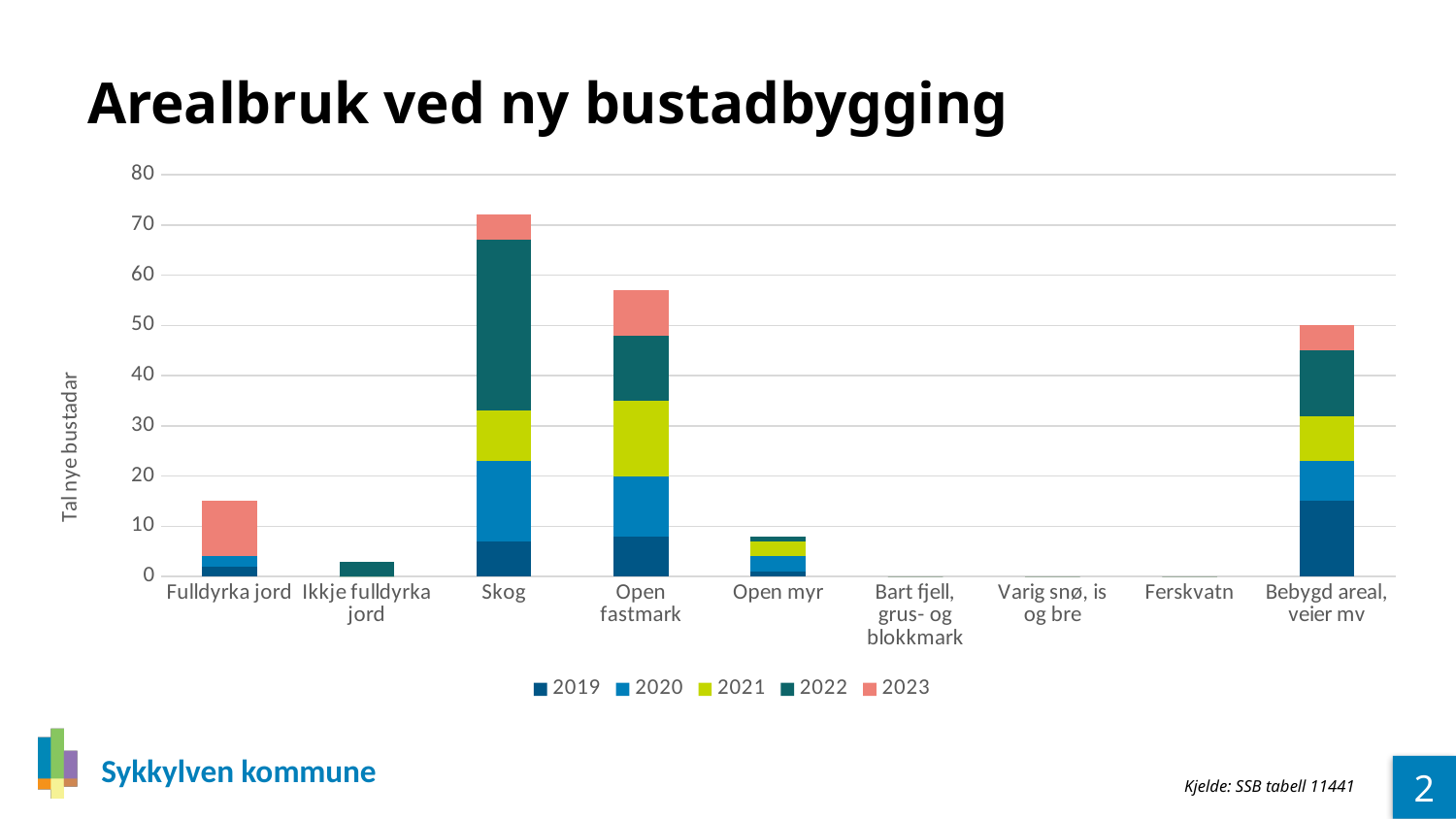
What kind of chart is shown on the slide? Stacked bar chart How many categories are shown on the x axis of the chart? 9 Is the total value for Open fastmark greater or less than 50? greater Is the total value for Fulldyrka jord greater or less than 20? less Is the total value for Skog greater or less than 60? greater What is the title of the chart on the slide? Arealbruk ved ny bustadbygging Which category has the highest total stacked bar? Skog Which has the taller total bar, Fulldyrka jord or Open myr? Fulldyrka jord Which has the taller total bar, Skog or Open fastmark? Skog What is the label on the y axis of the chart? Tal nye bustadar How many series does the legend list? 5